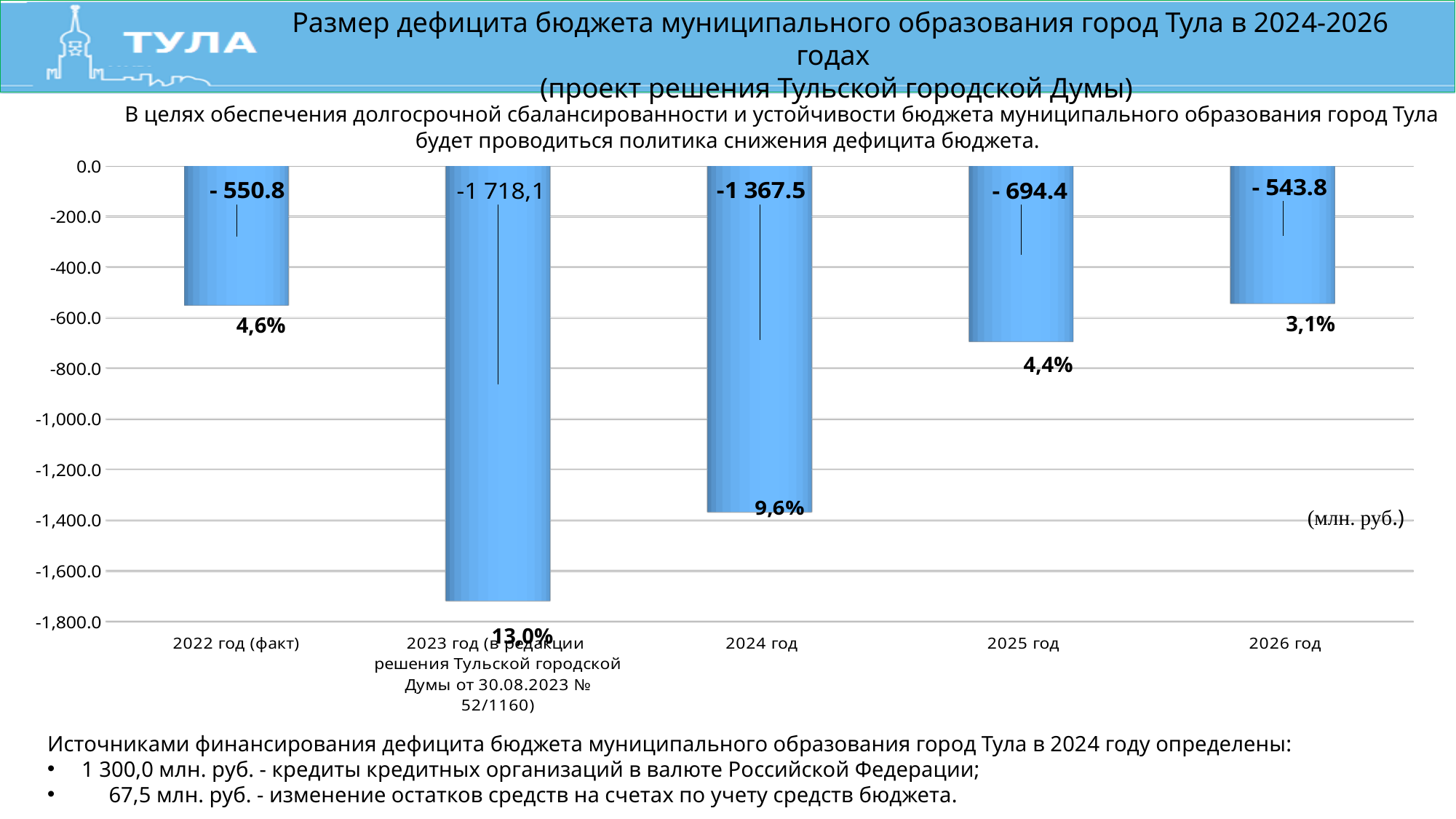
Which bar is longer: 2025 год or 2026 год? 2025 год By how much does the deficit for 2024 год exceed the deficit for 2025 год in absolute value? 673.1 In what units are the chart values given, according to the note on the chart? млн. руб. Which year has the largest deficit (the longest bar)? 2023 год What type of chart is shown on the slide? Bar chart What percentage is shown for 2024 год? 9,6% How many bars (years) are plotted in the chart? 5 Which year has the smallest deficit (the shortest bar)? 2026 год What is the value shown for 2022 год (факт)? - 550.8 What percentage is shown under the bar for 2025 год? 4,4% What is the budget deficit value shown for 2024 год? -1 367.5 What value is labelled on the bar for 2026 год? - 543.8